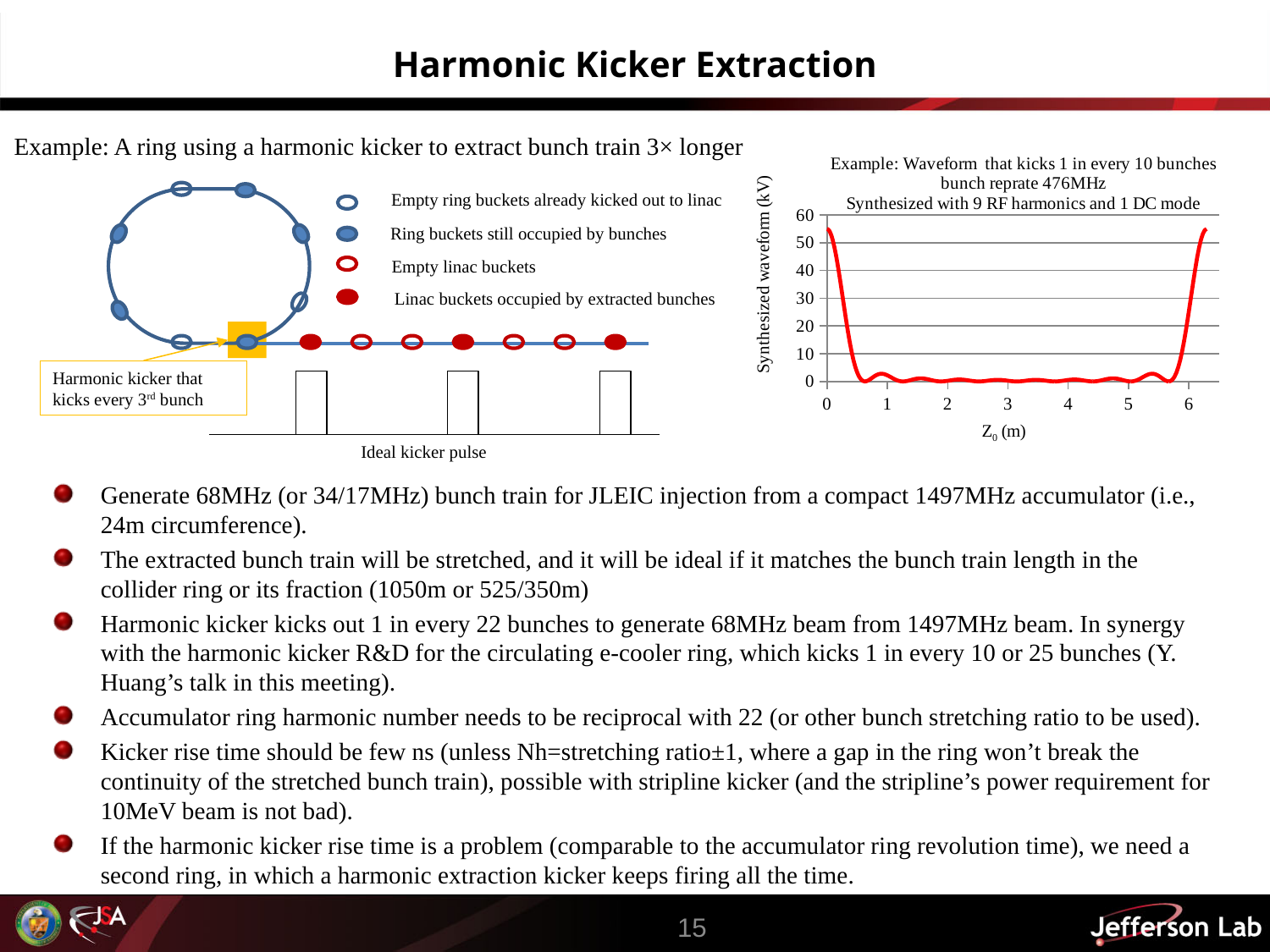
Is the synthesized waveform value at Z0 = 1 m greater or less than 20 kV? less Is the synthesized waveform value at Z0 = 3 m greater or less than 10 kV? less Does the synthesized waveform rise or fall between Z0 = 0 m and Z0 = 1 m? fall Does the synthesized waveform rise or fall between Z0 = 5 m and Z0 = 6 m? rise Is the synthesized waveform value at Z0 = 0 m greater or less than 50 kV? greater How many data series are plotted in the waveform chart? 1 Which is larger, the synthesized waveform value at Z0 = 0 m or at Z0 = 2 m? Z0 = 0 m What kind of chart is shown on the right side of the slide? line chart What is the highest tick value shown on the vertical axis of the waveform chart? 60 What is the label of the vertical axis of the waveform chart? Synthesized waveform (kV) What is the label of the horizontal axis of the waveform chart? Z0 (m)